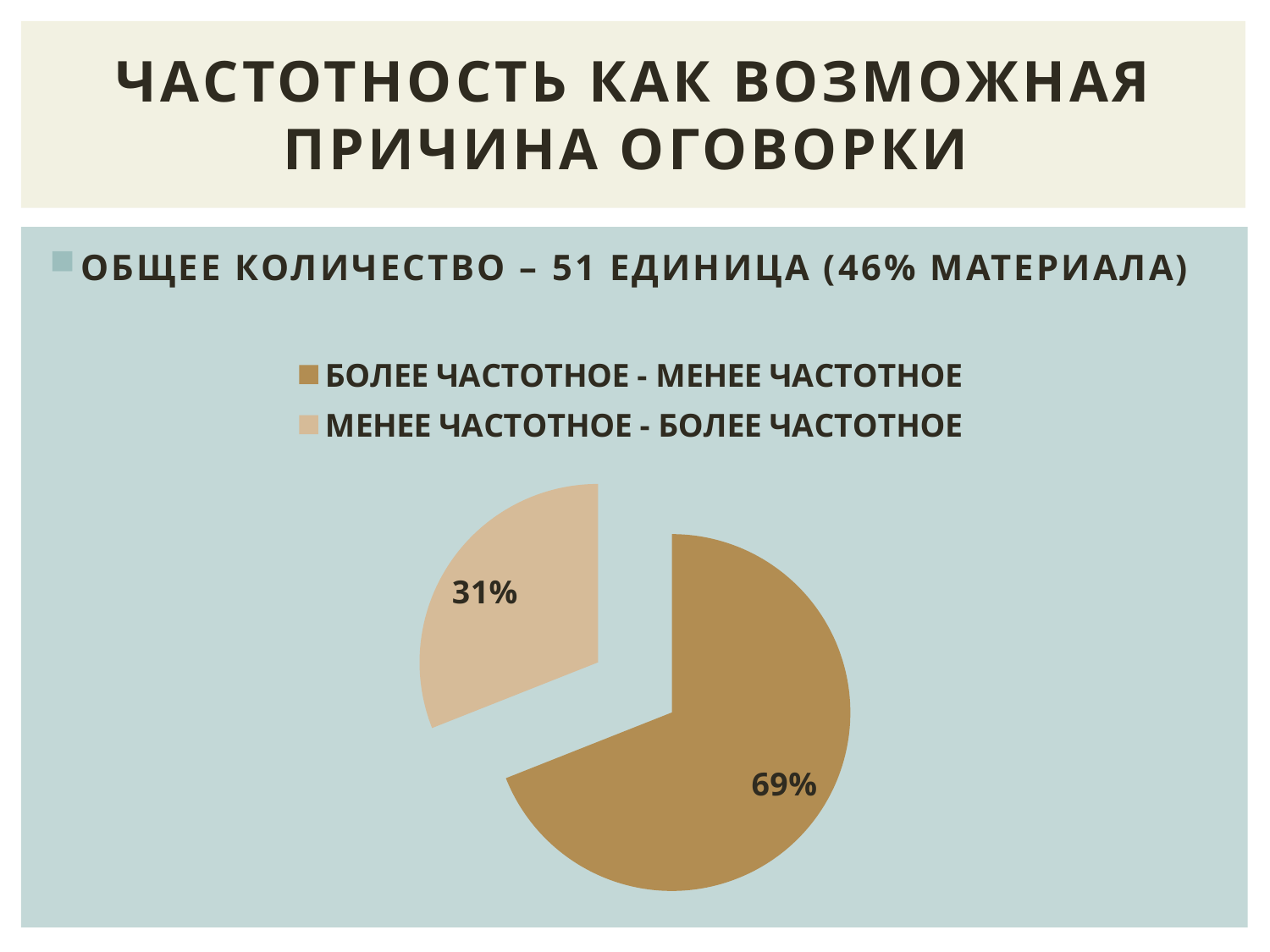
Which slice of the pie is the smallest? МЕНЕЕ ЧАСТОТНОЕ - БОЛЕЕ ЧАСТОТНОЕ Which is larger: the share for "БОЛЕЕ ЧАСТОТНОЕ - МЕНЕЕ ЧАСТОТНОЕ" or for "МЕНЕЕ ЧАСТОТНОЕ - БОЛЕЕ ЧАСТОТНОЕ"? БОЛЕЕ ЧАСТОТНОЕ - МЕНЕЕ ЧАСТОТНОЕ How many slices does the pie chart have? 2 What kind of chart is shown on the slide? pie chart What is the difference in percentage points between the two slices of the pie? 38 What share of the pie does "МЕНЕЕ ЧАСТОТНОЕ - БОЛЕЕ ЧАСТОТНОЕ" have? 31% Which legend entry is shown in the lighter beige colour? МЕНЕЕ ЧАСТОТНОЕ - БОЛЕЕ ЧАСТОТНОЕ Where is the legend placed relative to the pie chart? above the pie Which slice of the pie is the largest? БОЛЕЕ ЧАСТОТНОЕ - МЕНЕЕ ЧАСТОТНОЕ What share of the pie does "БОЛЕЕ ЧАСТОТНОЕ - МЕНЕЕ ЧАСТОТНОЕ" have? 69% How many entries does the legend list? 2